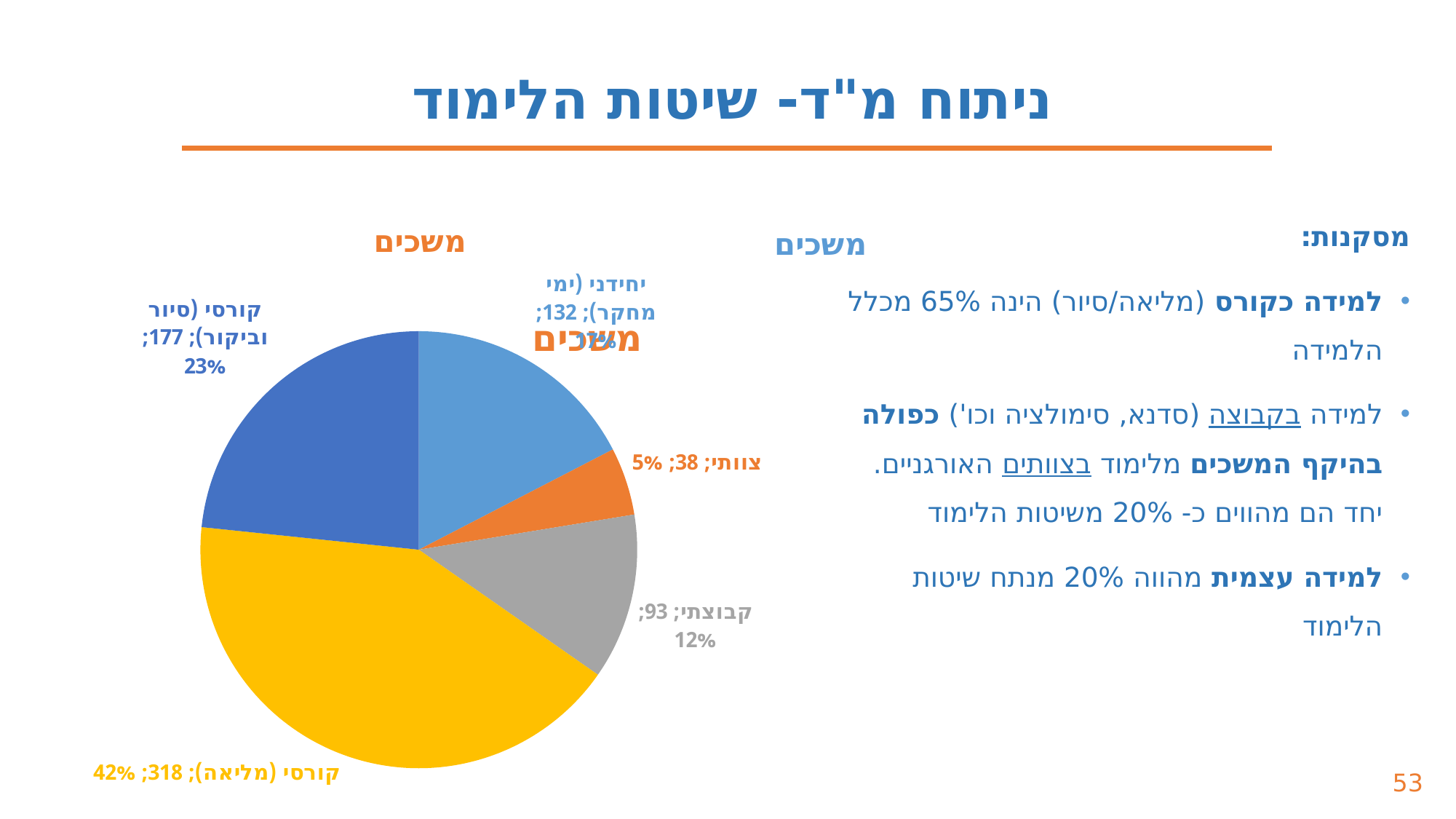
What is the difference between the values for קורסי (מליאה) and קורסי (סיור וביקור)? 141 Which is larger, the value for קבוצתי or the value for צוותי? קבוצתי What is the value for יחידני (ימי מחקר) in the pie chart? 132 Which category has the largest slice in the pie chart? קורסי (מליאה) What is the value for קורסי (מליאה) in the pie chart? 318 What is the value for צוותי in the pie chart? 38 How many slices does the pie chart have? 5 What is the value for קורסי (סיור וביקור) in the pie chart? 177 What share of the pie does קורסי (סיור וביקור) represent? 23% Which category has the smallest slice in the pie chart? צוותי What is the value for קבוצתי in the pie chart? 93 What type of chart is shown on the slide? pie chart